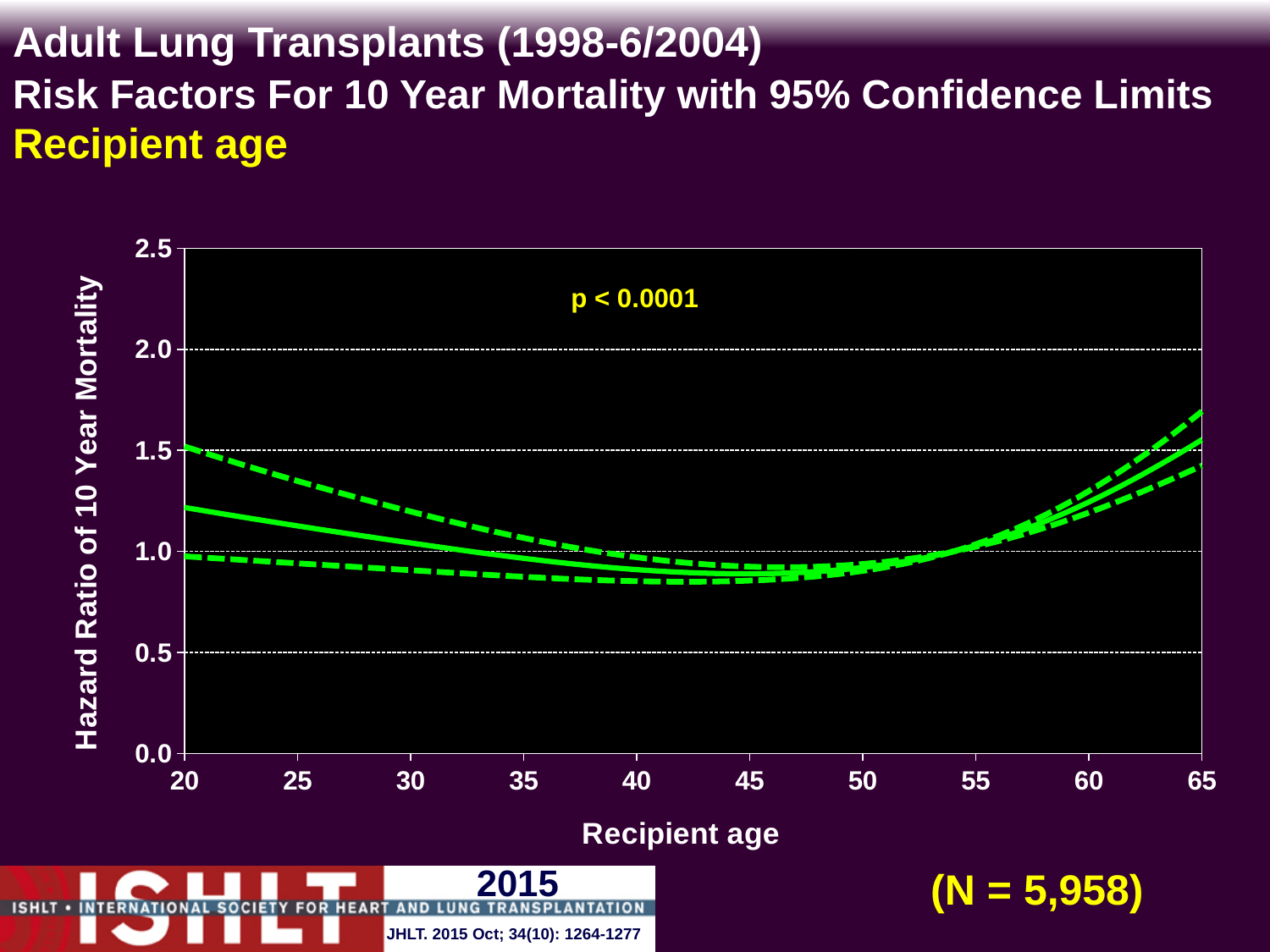
Is the hazard ratio on the solid line at recipient age 20 greater or less than 1.0? greater Does the solid hazard ratio line rise or fall as recipient age increases from 20 to 45? fall What is the label of the y axis? Hazard Ratio of 10 Year Mortality Is the upper dashed confidence limit at recipient age 20 greater or less than 1.0? greater What sample size (N) is shown on the slide? N = 5,958 Is the hazard ratio on the solid line at recipient age 65 greater or less than 1.0? greater What p-value is printed on the chart? p < 0.0001 Does the solid hazard ratio line rise or fall as recipient age increases from 55 to 65? rise What is the label of the x axis? Recipient age What kind of chart is shown on the slide? line chart How many lines are plotted on the chart? 3